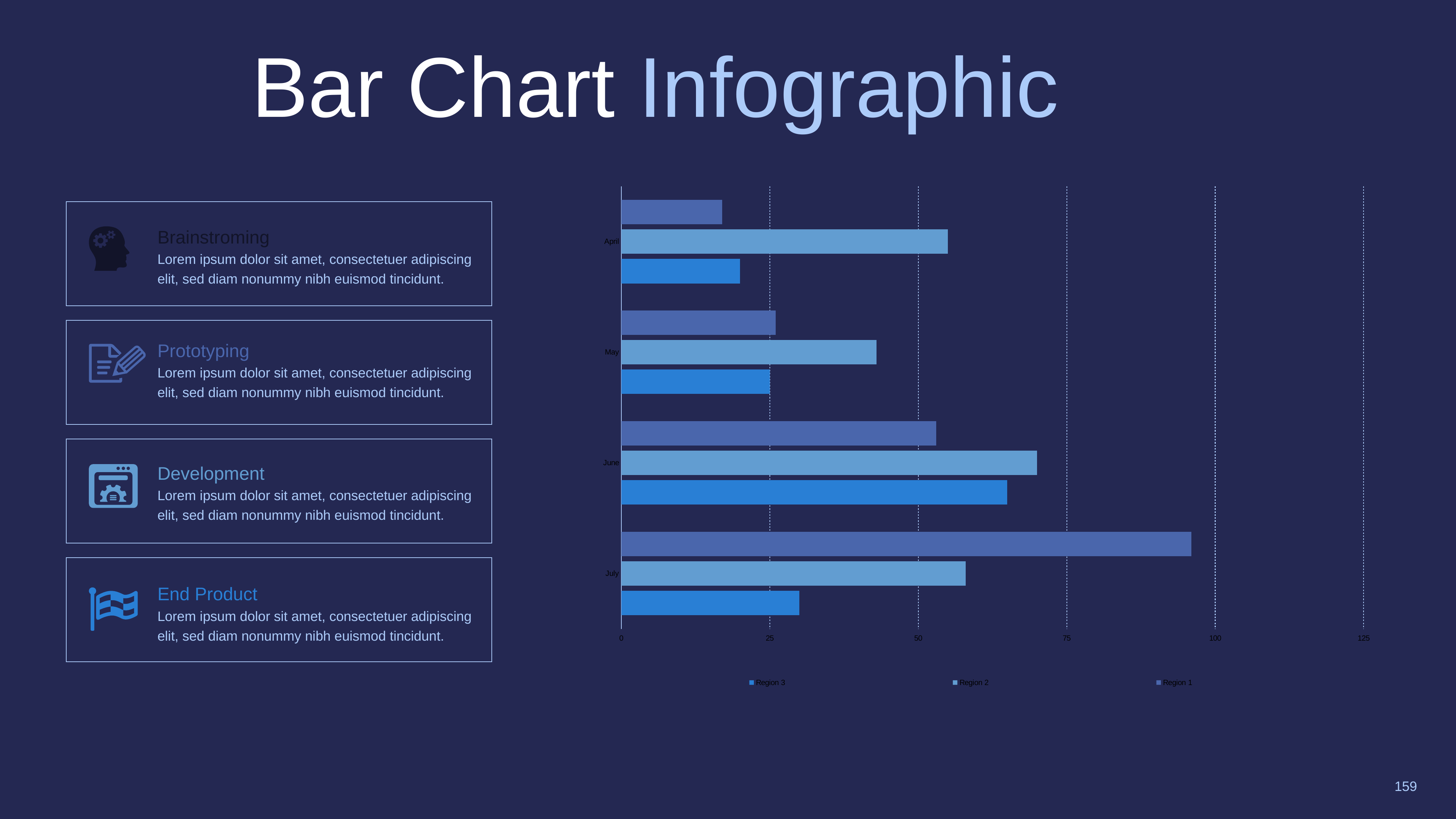
What is the highest value shown on the chart's horizontal axis? 125 Which is larger in July, the Region 1 value or the Region 3 value? Region 1 Is the Region 2 value for June greater or less than 50? greater Is the Region 1 value for July greater or less than 75? greater What kind of chart is shown on the slide? bar chart How many month categories are shown on the chart's vertical axis? 4 How many series does the chart's legend list? 3 Is the Region 2 value for April greater or less than 50? greater Which is larger in April, the Region 2 value or the Region 1 value? Region 2 Which month has the longest bar overall in the chart? July Which series is listed first in the chart's legend? Region 3